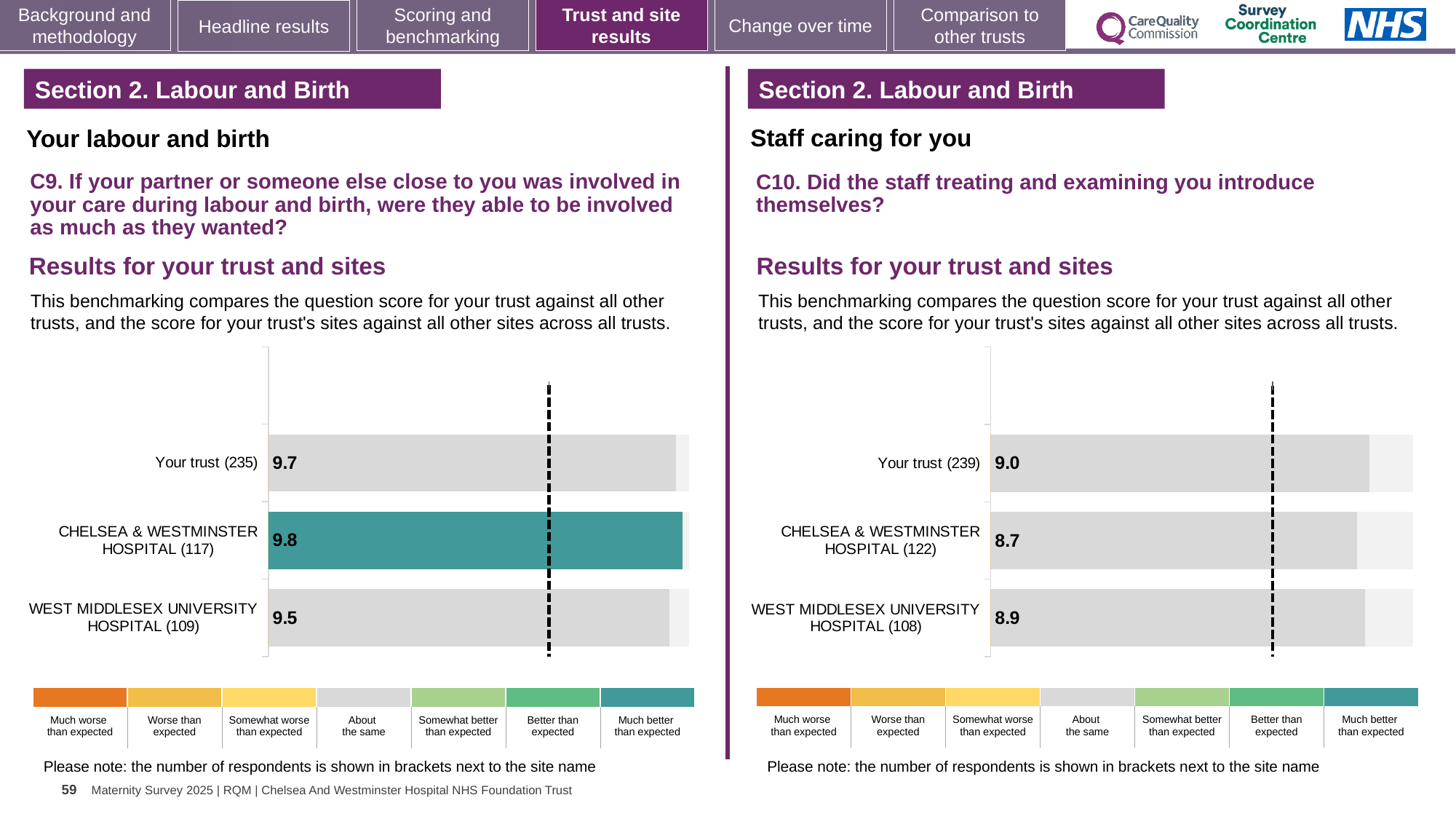
In the C9 chart on the left, how many bars are plotted? 3 In the C10 chart on the right, which site or trust has the lowest score? CHELSEA & WESTMINSTER HOSPITAL In the C9 chart on the left, what is the difference between the scores for CHELSEA & WESTMINSTER HOSPITAL and WEST MIDDLESEX UNIVERSITY HOSPITAL? 0.3 What type of chart is used in the C9 chart on the left? Bar chart In the C9 chart on the left, which site or trust has the highest score? CHELSEA & WESTMINSTER HOSPITAL In the C10 chart on the right, what is the difference between the scores for Your trust and WEST MIDDLESEX UNIVERSITY HOSPITAL? 0.1 In the C10 chart on the right, what is the score for Your trust? 9.0 In the C9 chart on the left, what is the score for CHELSEA & WESTMINSTER HOSPITAL? 9.8 In the C9 chart on the left, which benchmarking category does the colour of the CHELSEA & WESTMINSTER HOSPITAL bar indicate? Much better than expected In the C9 chart on the left, what is the score for WEST MIDDLESEX UNIVERSITY HOSPITAL? 9.5 In the C10 chart on the right, what is the score for CHELSEA & WESTMINSTER HOSPITAL? 8.7 In the C10 chart on the right, which has the larger score: WEST MIDDLESEX UNIVERSITY HOSPITAL or CHELSEA & WESTMINSTER HOSPITAL? WEST MIDDLESEX UNIVERSITY HOSPITAL